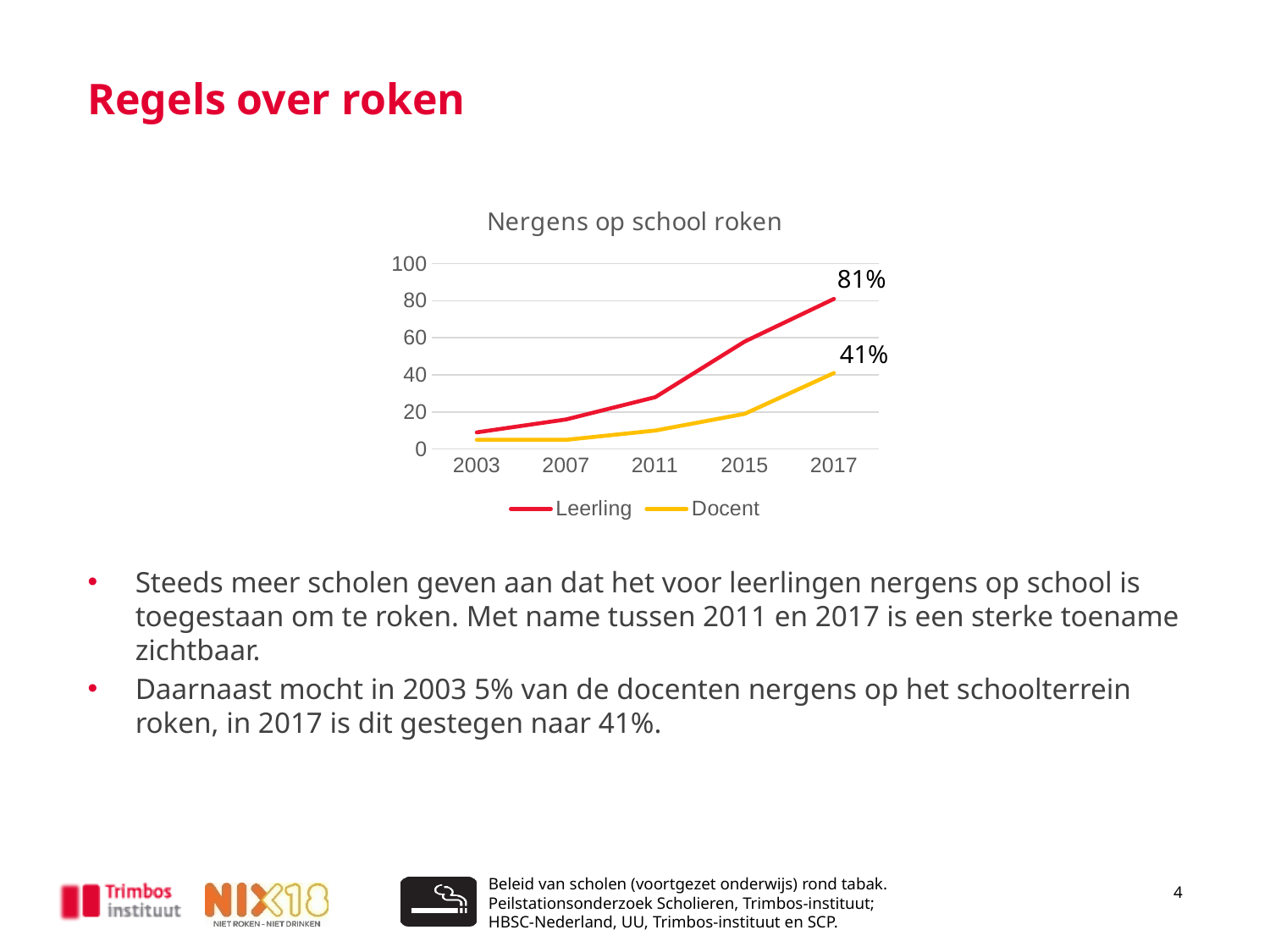
What is the value for Docent in 2017? 41% What is the value for Leerling in 2017? 81% In which year does the Leerling series reach its highest value? 2017 What type of chart is shown on the slide? line chart What is the title of the chart? Nergens op school roken Is the value for Docent in 2011 greater or less than 20? less Is the value for Leerling in 2011 greater or less than 40? less How many series does the chart legend list? 2 Do the values for Leerling rise or fall from 2003 to 2017? rise How many years are shown on the x axis of the chart? 5 What is the difference between the Leerling and Docent values in 2017? 40 percentage points In 2017, which series has the higher value, Leerling or Docent? Leerling